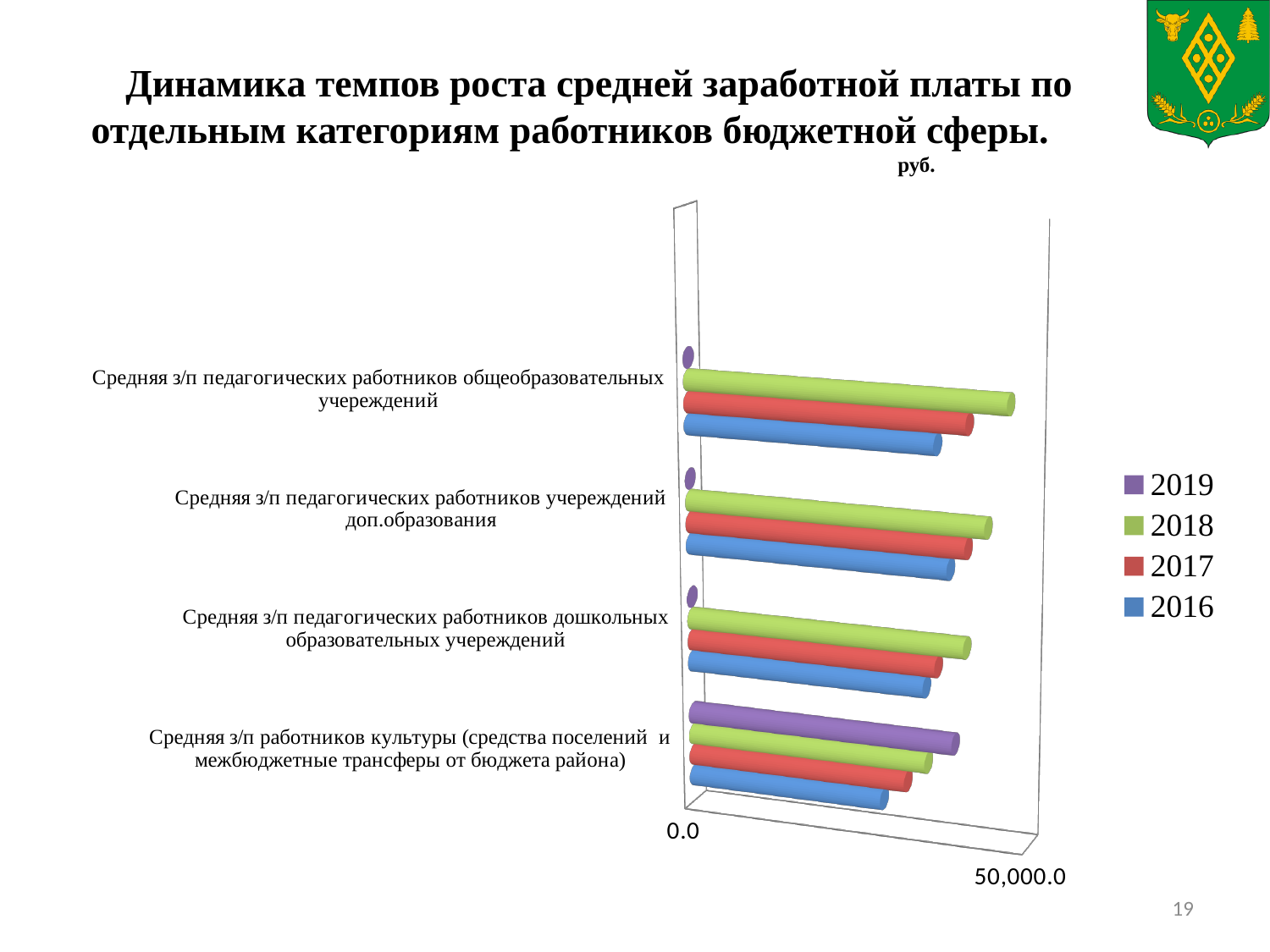
What unit is indicated above the chart? руб. Which years are listed in the chart legend? 2019, 2018, 2017, 2016 For 'Средняя з/п педагогических работников общеобразовательных учереждений', which is larger: the 2018 value or the 2016 value? 2018 Which category has the lowest 2016 value? Средняя з/п работников культуры (средства поселений и межбюджетные трансферы от бюджета района) Which category is the only one with a clearly visible 2019 bar? Средняя з/п работников культуры (средства поселений и межбюджетные трансферы от бюджета района) Is the 2018 value for 'Средняя з/п педагогических работников общеобразовательных учереждений' greater or less than 50,000.0? less How many categories of workers are shown on the chart? 4 Which category has the highest 2018 value? Средняя з/п педагогических работников общеобразовательных учереждений What kind of chart is shown on the slide? bar chart For 'Средняя з/п работников культуры (средства поселений и межбюджетные трансферы от бюджета района)', which is larger: the 2019 value or the 2017 value? 2019 How many series does the legend list? 4 For 'Средняя з/п педагогических работников дошкольных образовательных учереждений', do the values rise or fall from 2016 to 2018? rise